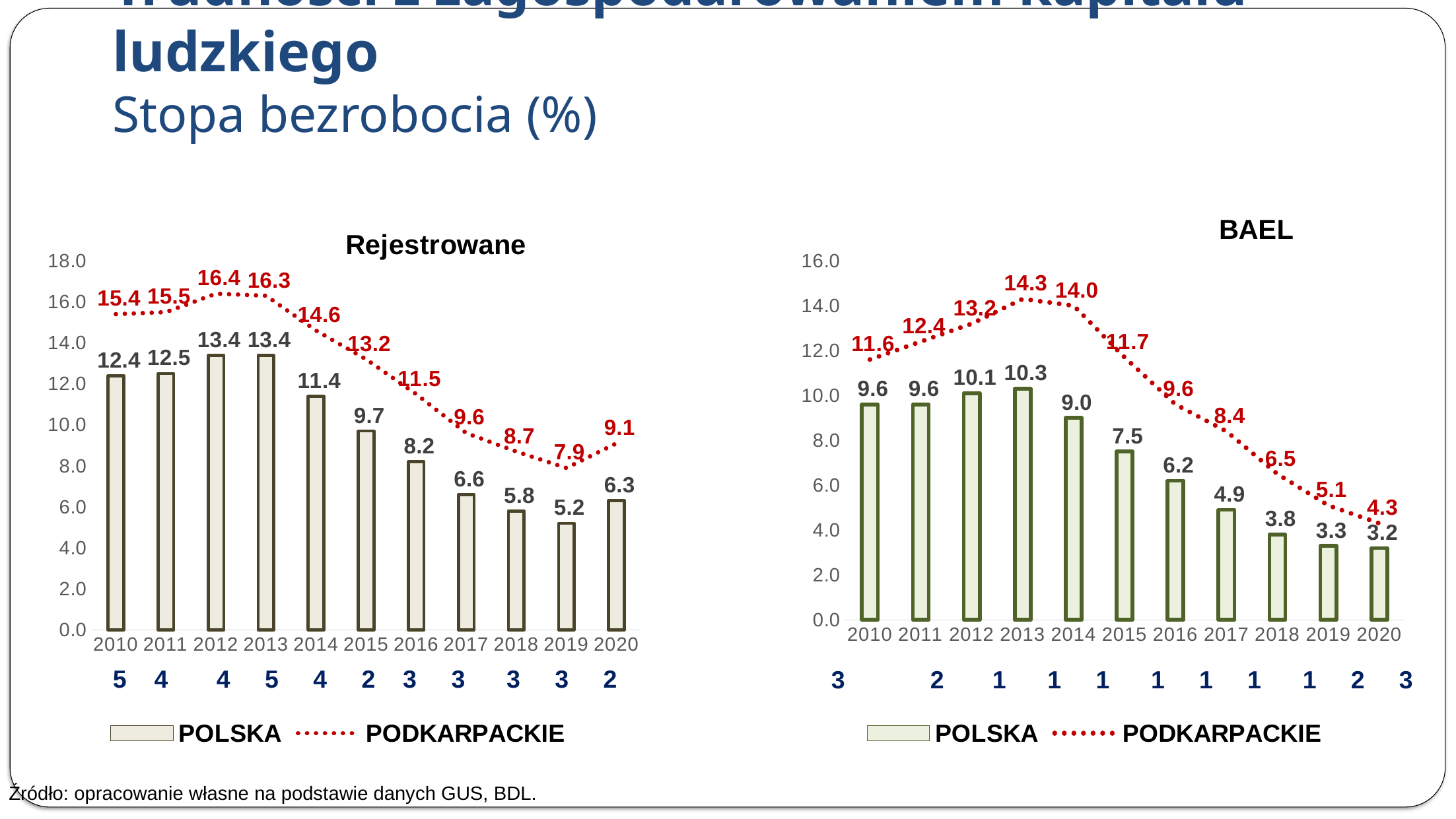
In the BAEL chart, which year has the highest value for PODKARPACKIE? 2013 In the BAEL chart, what is the difference between PODKARPACKIE and POLSKA in 2010? 2.0 In the BAEL chart, what is the value for PODKARPACKIE in 2013? 14.3 In the Rejestrowane chart, what is the value for POLSKA in 2014? 11.4 In the Rejestrowane chart, which year has the lowest value for POLSKA? 2019 In the BAEL chart, what is the value for POLSKA in 2017? 4.9 In the Rejestrowane chart, what is the difference between PODKARPACKIE and POLSKA in 2020? 2.8 In the BAEL chart, how many series does the legend list? 2 In the Rejestrowane chart, what is the value for PODKARPACKIE in 2012? 16.4 In the Rejestrowane chart, how many years are shown on the x axis? 11 In the BAEL chart, does the POLSKA value rise or fall from 2014 to 2020? fall In the BAEL chart, which is larger: POLSKA in 2012 or POLSKA in 2015? POLSKA in 2012